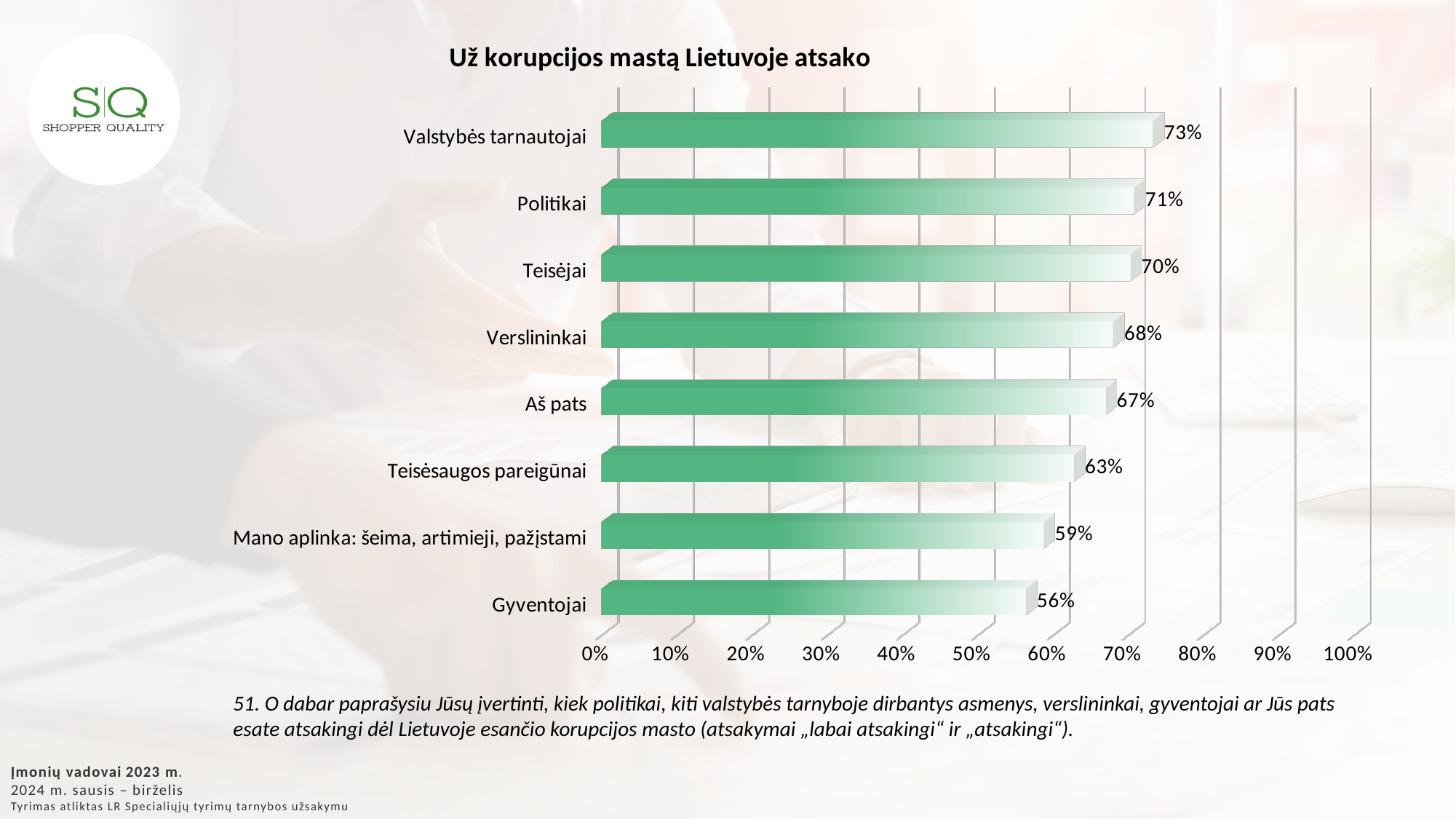
Which is larger, the value for Politikai or the value for Aš pats? Politikai What is the value for Teisėsaugos pareigūnai? 63% What kind of chart is shown on the slide? Bar chart What is the value for Mano aplinka: šeima, artimieji, pažįstami? 59% Which category has the highest value? Valstybės tarnautojai What is the value for Valstybės tarnautojai? 73% Which category has the lowest value? Gyventojai What is the value for Gyventojai? 56% What is the difference between the values for Valstybės tarnautojai and Gyventojai? 17% What is the title of the chart? Už korupcijos mastą Lietuvoje atsako How many categories are shown in the chart? 8 What is the difference between the values for Verslininkai and Teisėsaugos pareigūnai? 5%